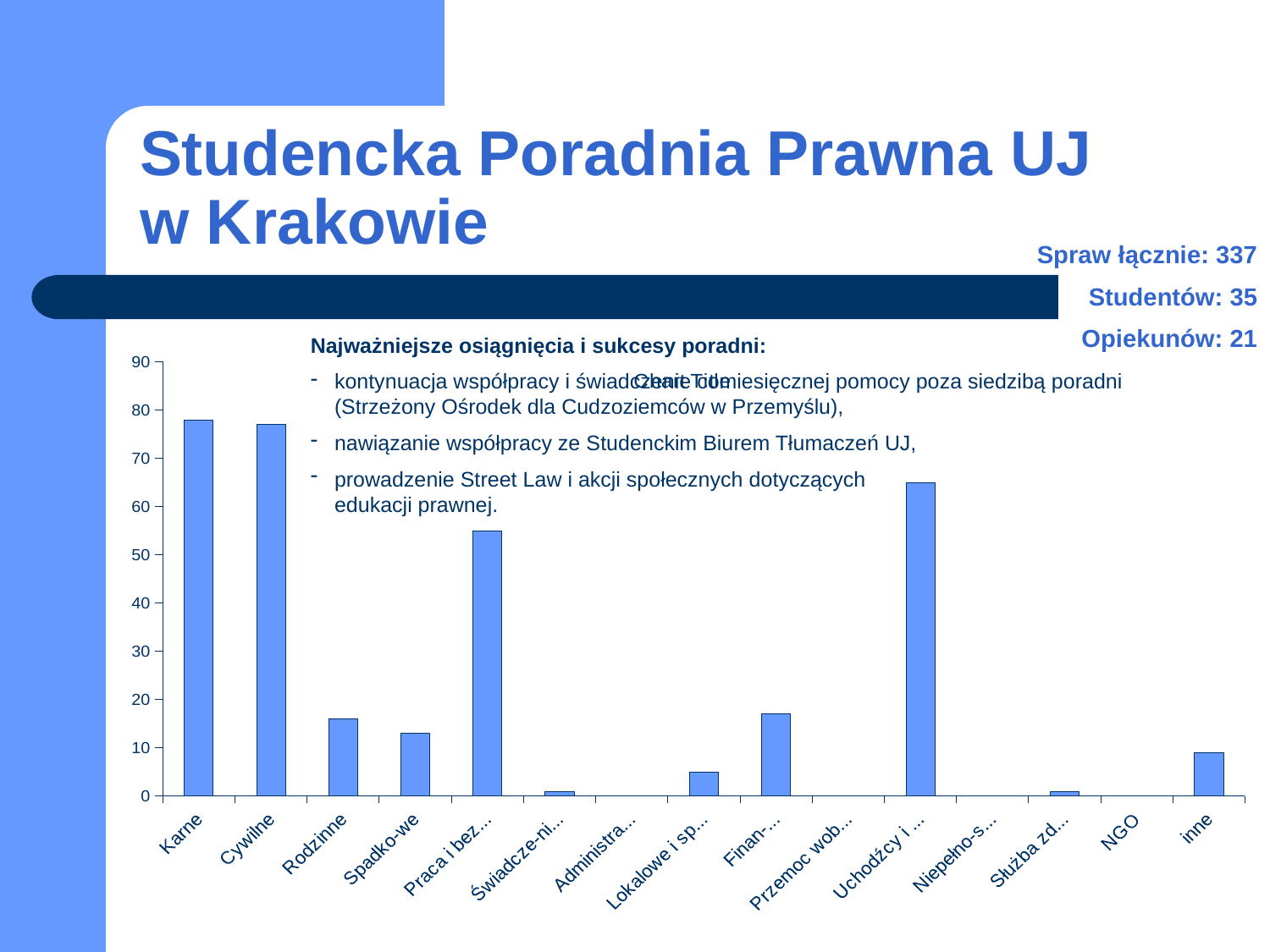
Is the value for Rodzinne greater or less than 20? less Is the value for the category labelled 'Uchodźcy i ...' greater or less than 60? greater Is the value for Spadko-we greater or less than 10? greater What is the highest value shown on the y axis of the chart? 90 Which has a larger value, the category labelled 'Finan-...' or the category labelled 'Lokalowe i sp...'? Finan-... What kind of chart is shown on the slide? bar chart How many categories are shown on the x axis of the chart? 15 Which has a larger value, the category labelled 'Praca i bez...' or the category labelled 'Uchodźcy i ...'? Uchodźcy i ...